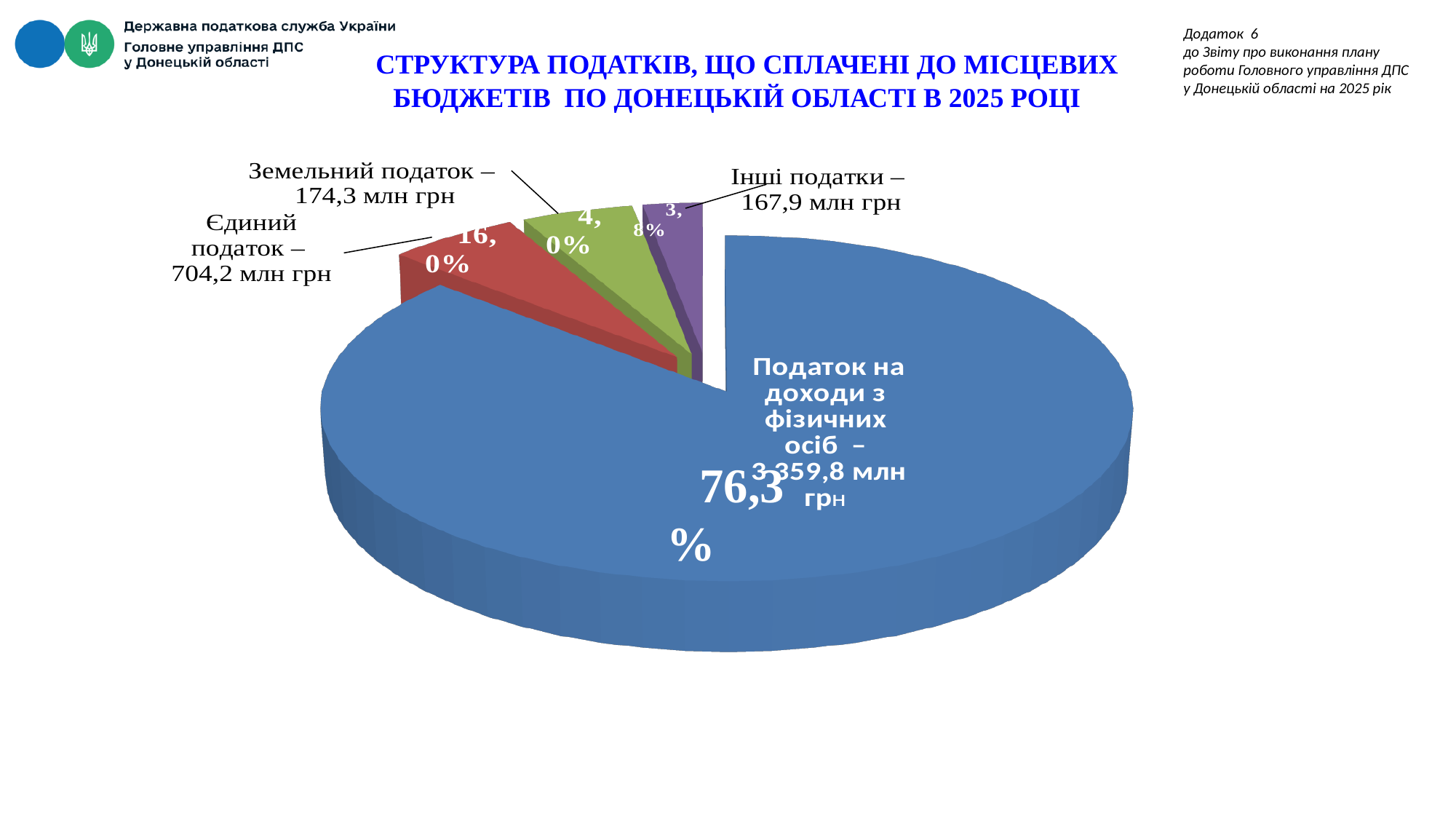
Which category has the smallest slice of the pie? Інші податки What type of chart is shown on the slide? Pie chart What share of the pie does Податок на доходи з фізичних осіб represent? 76,3% What is the value for Податок на доходи з фізичних осіб? 3 359,8 млн грн How many slices does the pie chart have? 4 Which is larger, the value for Земельний податок or the value for Інші податки? Земельний податок What is the difference between the values for Єдиний податок and Земельний податок? 529,9 млн грн What share of the pie does Єдиний податок represent? 16,0% What is the value for Земельний податок? 174,3 млн грн Which category has the largest slice of the pie? Податок на доходи з фізичних осіб What is the value for Інші податки? 167,9 млн грн What is the value for Єдиний податок? 704,2 млн грн